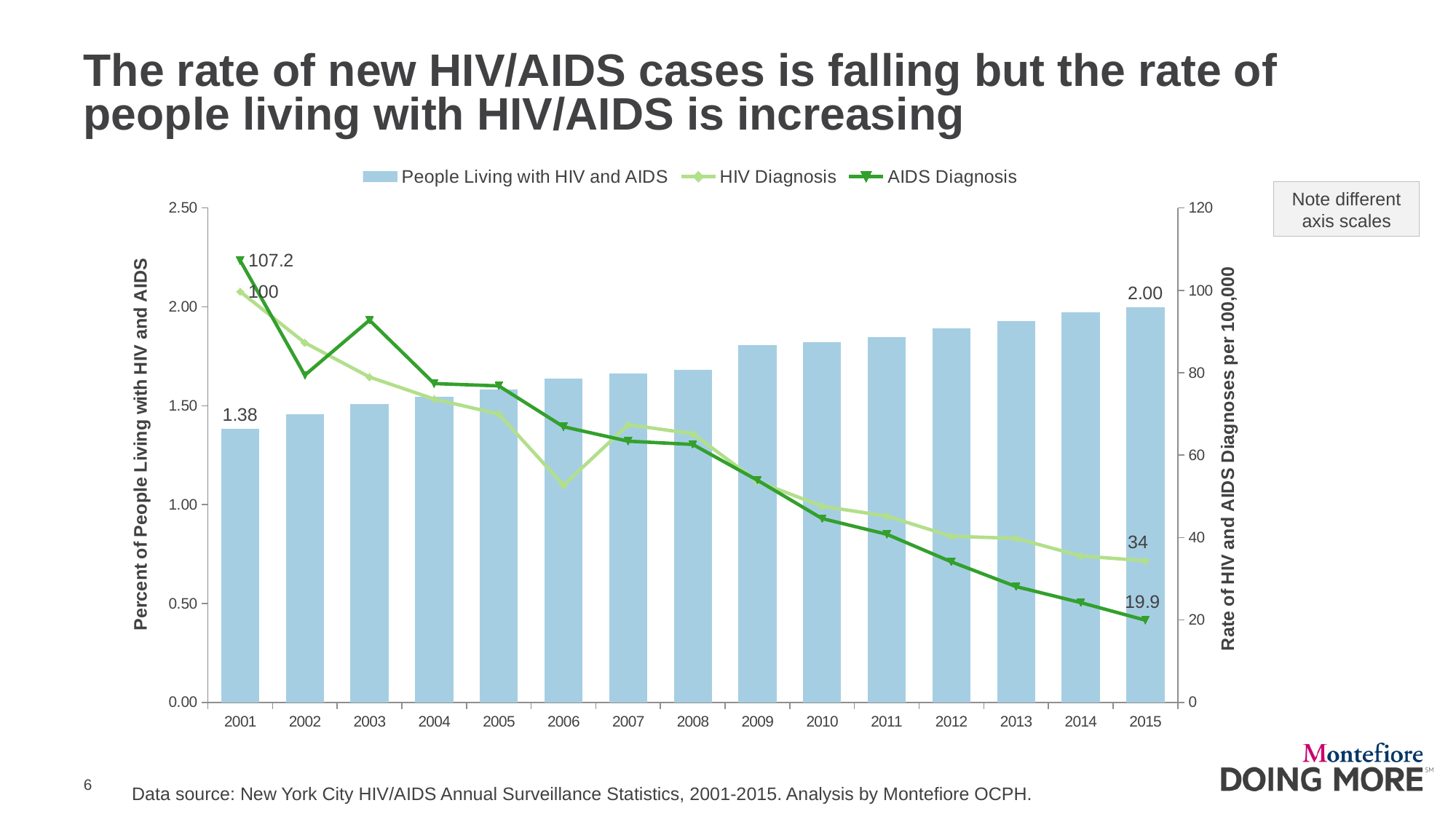
What is the HIV Diagnosis rate in 2015? 34 How many years are shown on the x axis? 15 In 2001, which is larger: the HIV Diagnosis rate or the AIDS Diagnosis rate? AIDS Diagnosis What is the AIDS Diagnosis rate in 2015? 19.9 Do the People Living with HIV and AIDS bars rise or fall from 2001 to 2015? rise What is the value for People Living with HIV and AIDS in 2001? 1.38 What is the value for People Living with HIV and AIDS in 2015? 2.00 Is the value for People Living with HIV and AIDS in 2008 greater or less than 1.50? greater What is the AIDS Diagnosis rate in 2001? 107.2 How many series does the legend list? 3 By how much did the percent of People Living with HIV and AIDS increase from 2001 to 2015? 0.62 What is the difference between the AIDS Diagnosis rate in 2001 and in 2015? 87.3